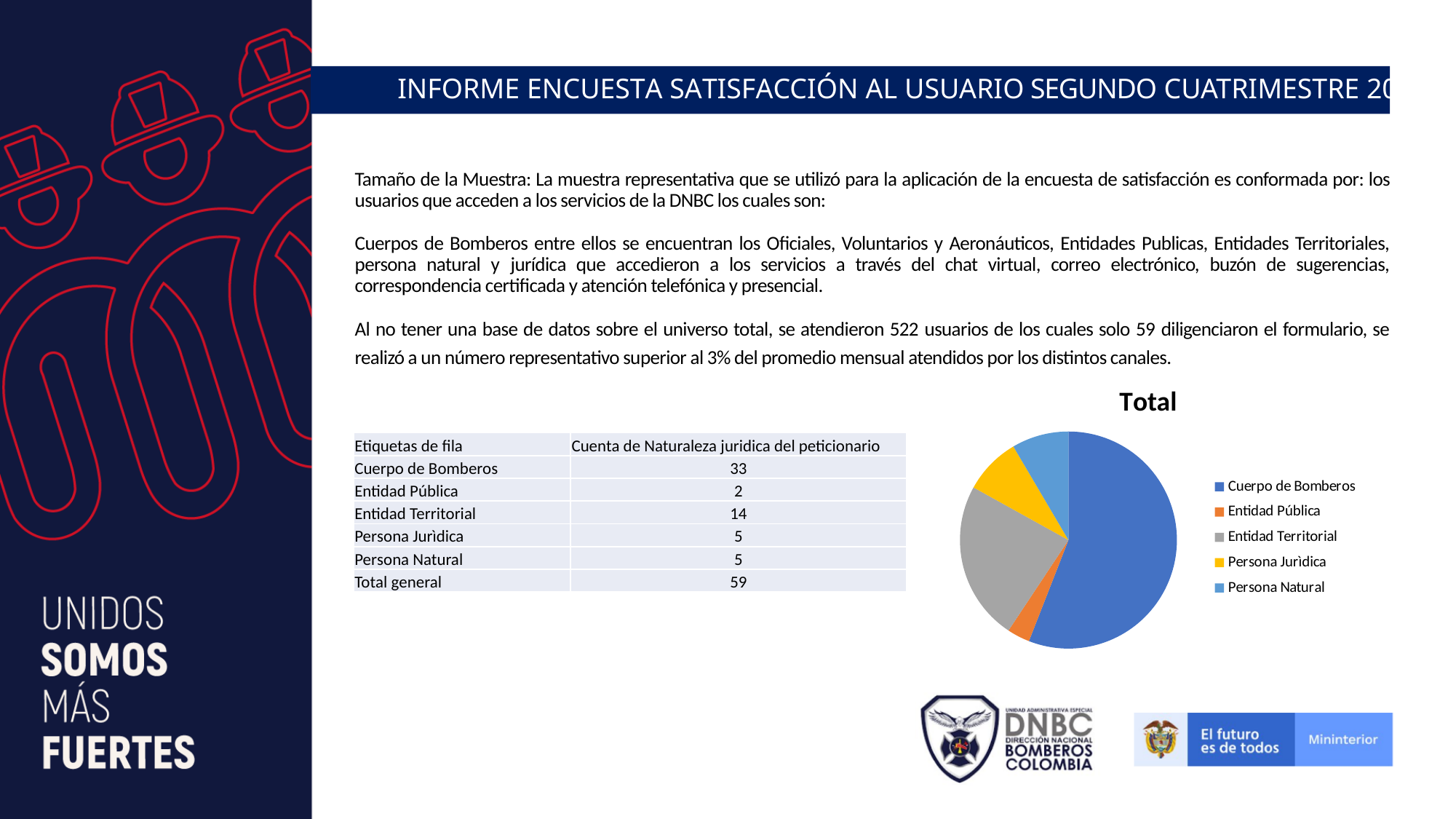
What kind of chart is shown on the slide? pie chart Which category has the largest slice in the pie chart? Cuerpo de Bomberos According to the table accompanying the pie chart, what is the count for Cuerpo de Bomberos? 33 What colour is the Cuerpo de Bomberos slice in the pie chart? blue Which slice is larger in the pie chart, Entidad Territorial or Persona Jurìdica? Entidad Territorial Using the table values, what is the difference between the counts for Cuerpo de Bomberos and Entidad Territorial? 19 Which category has the smallest slice in the pie chart? Entidad Pública How many categories does the legend of the pie chart list? 5 According to the table accompanying the pie chart, what is the Total general? 59 Which slice is larger in the pie chart, Cuerpo de Bomberos or Entidad Territorial? Cuerpo de Bomberos According to the table accompanying the pie chart, what is the count for Entidad Territorial? 14 What is the title of the pie chart? Total